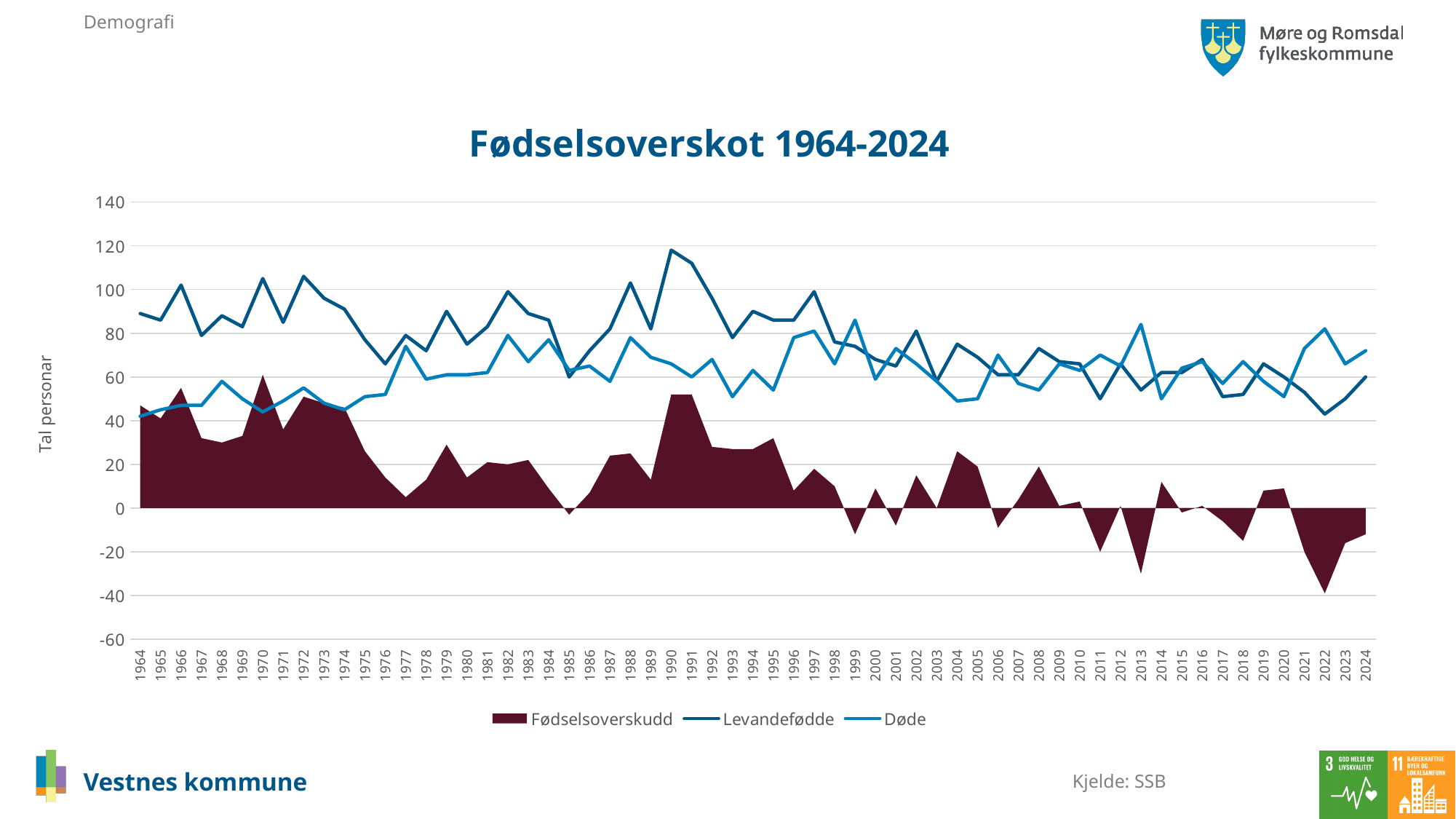
What is the title of the chart? Fødselsoverskot 1964-2024 In which year is the Fødselsoverskudd value lowest? 2022 What kind of chart is shown on the slide? A combined area and line chart Is the Levandefødde value for 1990 greater or less than 100? greater Is the Fødselsoverskudd value for 2022 greater or less than -20? less In which year does the Levandefødde series reach its lowest value? 2022 How many series does the legend list? 3 How many years are plotted along the x axis? 61 In which year does the Levandefødde series reach its highest value? 1990 Does the Levandefødde series overall rise or fall from 1964 to 2024? fall What are the three series named in the legend? Fødselsoverskudd, Levandefødde, Døde In 1964, which is larger: Levandefødde or Døde? Levandefødde